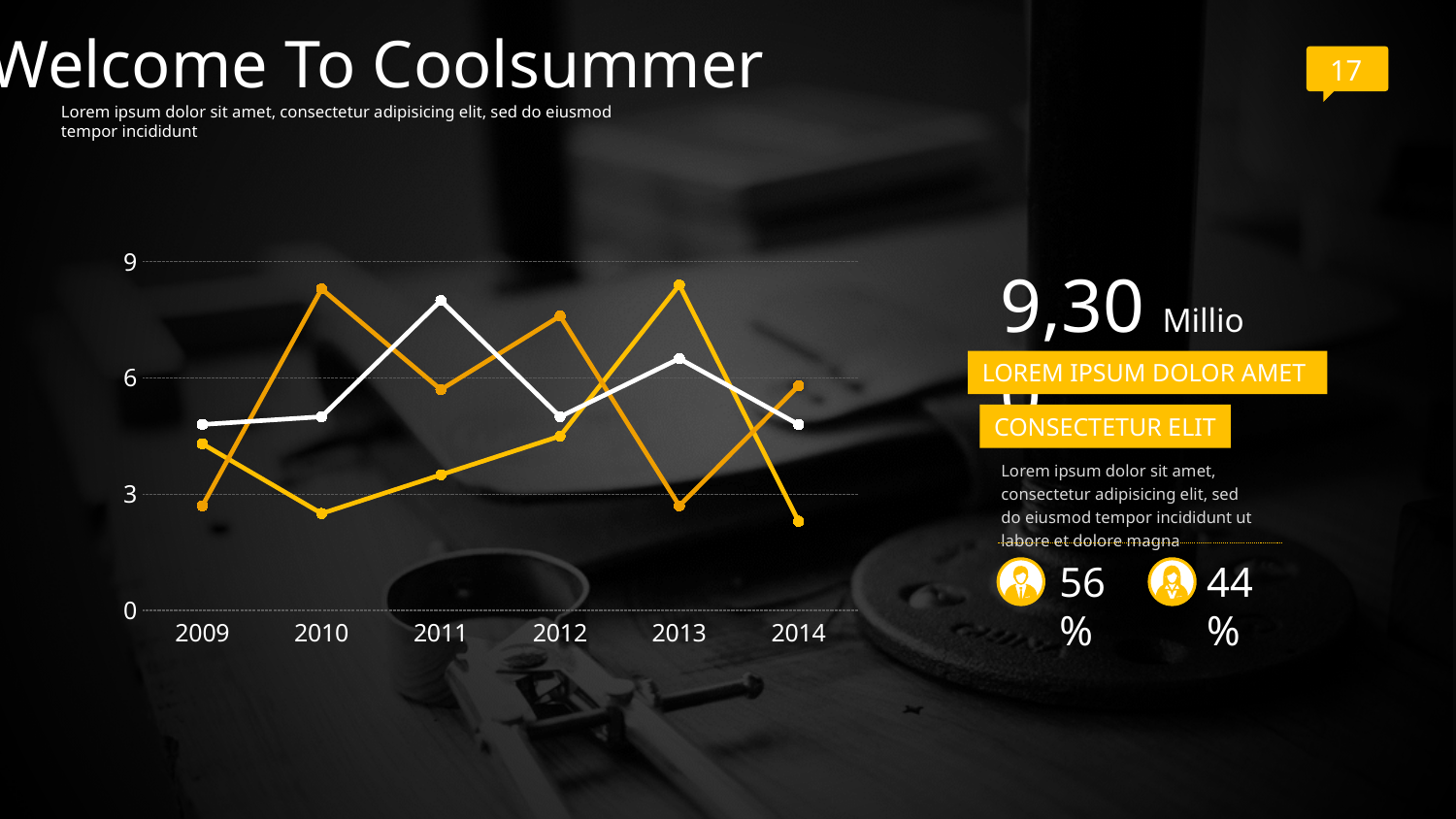
What kind of chart is shown on the slide? line chart How many lines are plotted on the chart? 3 What is the last year shown on the x axis of the chart? 2014 Is the value of the white line in 2009 greater or less than 6? less What is the highest value shown on the y axis of the chart? 9 Is the value of the white line in 2013 greater or less than 3? greater Which is larger in 2011: the value of the white line or the value of the lowest line? the white line How many years are shown on the x axis of the chart? 6 What is the first year shown on the x axis of the chart? 2009 In which year does the white line reach its highest value? 2011 Does the white line rise or fall between 2010 and 2011? rise Is the value of the white line in 2011 greater or less than 6? greater